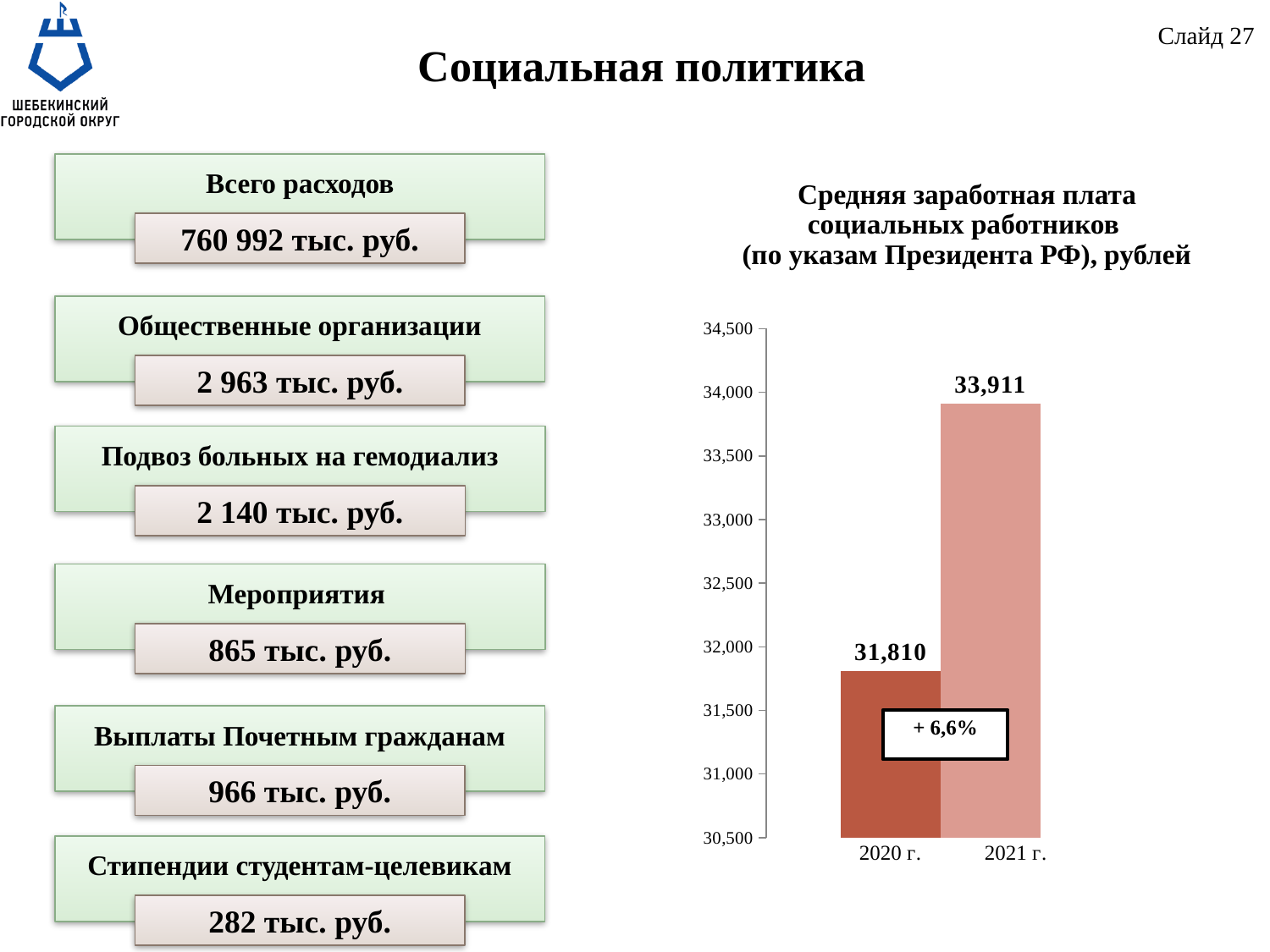
How many bars are plotted in the chart? 2 By how much did the average salary of social workers increase from 2020 г. to 2021 г.? 2,101 Which year has the lower average salary of social workers? 2020 г. Is the value for 2020 г. greater or less than 32,000? less What is the average salary of social workers shown for 2021 г.? 33,911 What percentage change is annotated on the chart between the two bars? + 6,6% Is the value for 2021 г. greater or less than 33,500? greater What is the average salary of social workers shown for 2020 г.? 31,810 Is the value for 2021 г. larger or smaller than the value for 2020 г.? larger Which year has the higher average salary of social workers? 2021 г. What type of chart is used to show the average salary of social workers? bar chart Does the average salary of social workers rise or fall from 2020 г. to 2021 г.? rise